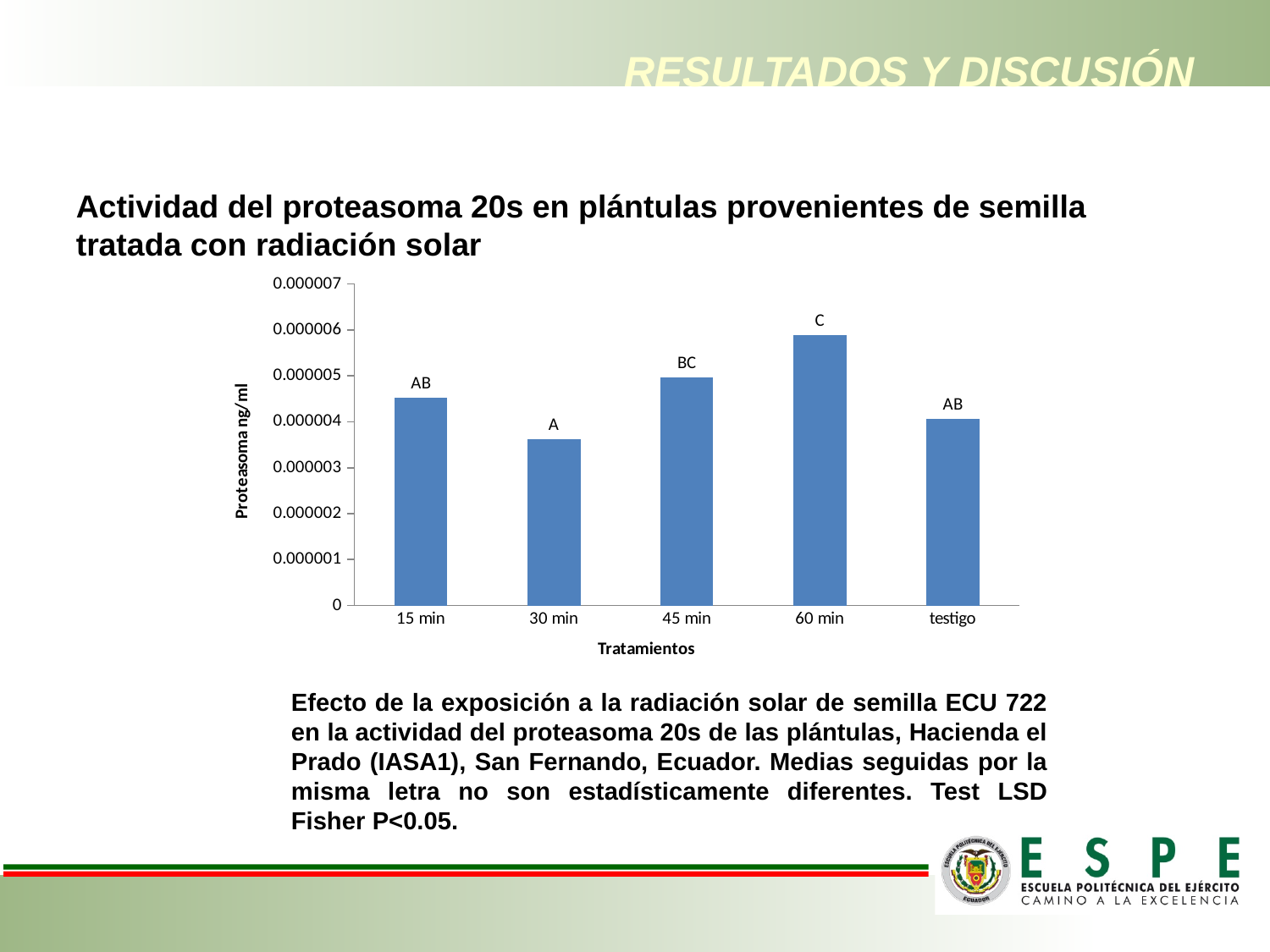
Is the value for 30 min greater or less than 0.000004? less How many treatment categories are plotted on the x axis? 5 Which is larger, the value for 45 min or the value for testigo? 45 min Is the value for 15 min greater or less than 0.000004? greater Which is larger, the value for 15 min or the value for 30 min? 15 min What kind of chart is shown on the slide? bar chart Is the value for 60 min greater or less than 0.000005? greater What statistical letter label is shown above the 60 min bar? C What is the title of the y axis? Proteasoma ng/ml Which treatment has the highest proteasome activity? 60 min Which treatment has the lowest proteasome activity? 30 min